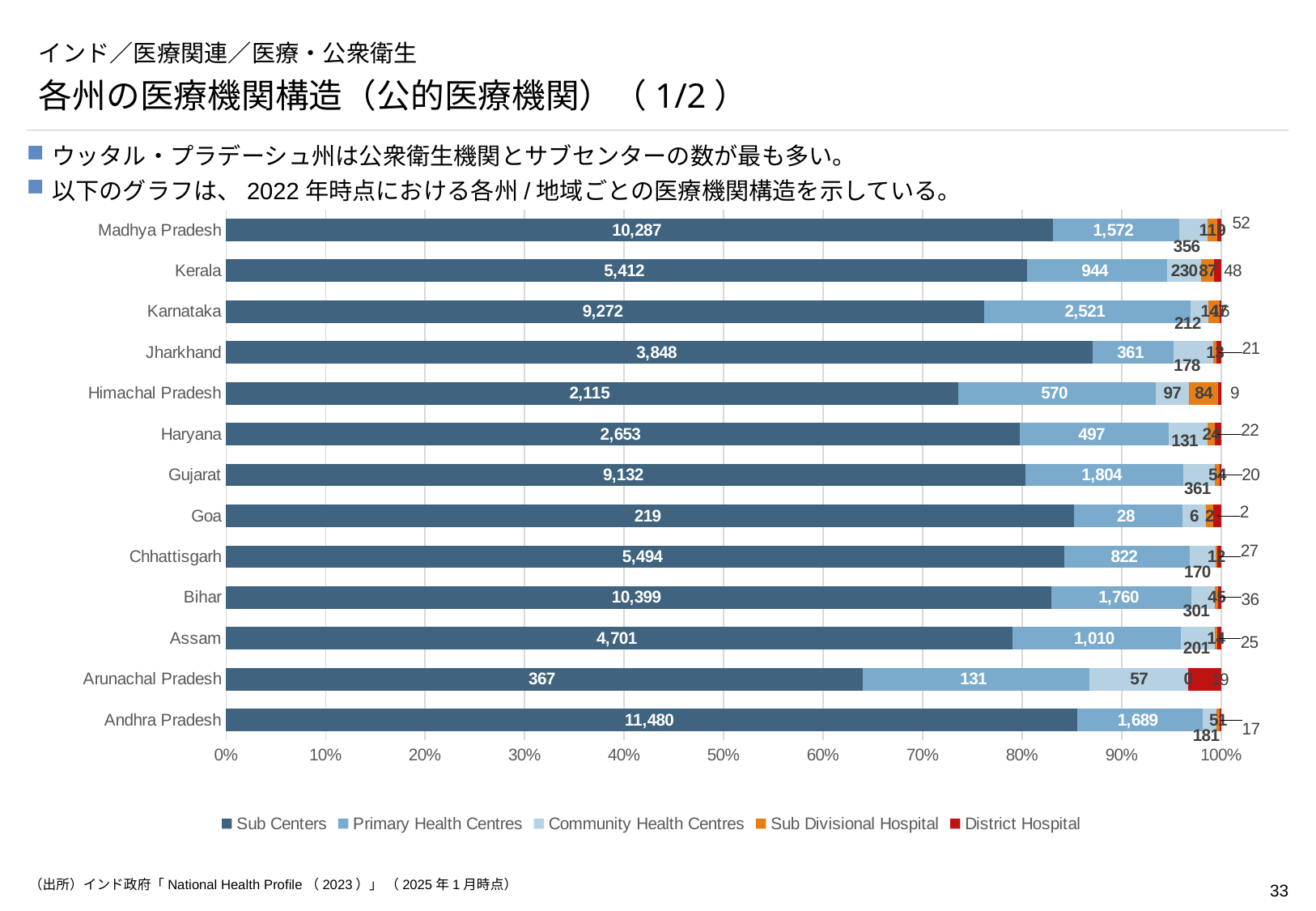
Which has more Sub Centers, Bihar or Madhya Pradesh? Bihar What is the number of Sub Centers in Andhra Pradesh? 11,480 How many series does the legend list? 5 Which state has the lowest number of Primary Health Centres? Goa What is the number of Sub Divisional Hospitals in Himachal Pradesh? 84 What is the difference in the number of Sub Centers between Andhra Pradesh and Bihar? 1,081 What is the number of Community Health Centres in Gujarat? 361 Which state has the highest number of Sub Centers? Andhra Pradesh What is the difference in the number of Primary Health Centres between Karnataka and Gujarat? 717 What is the number of Primary Health Centres in Karnataka? 2,521 How many states are shown in the chart? 13 What kind of chart is shown on the slide? Stacked bar chart